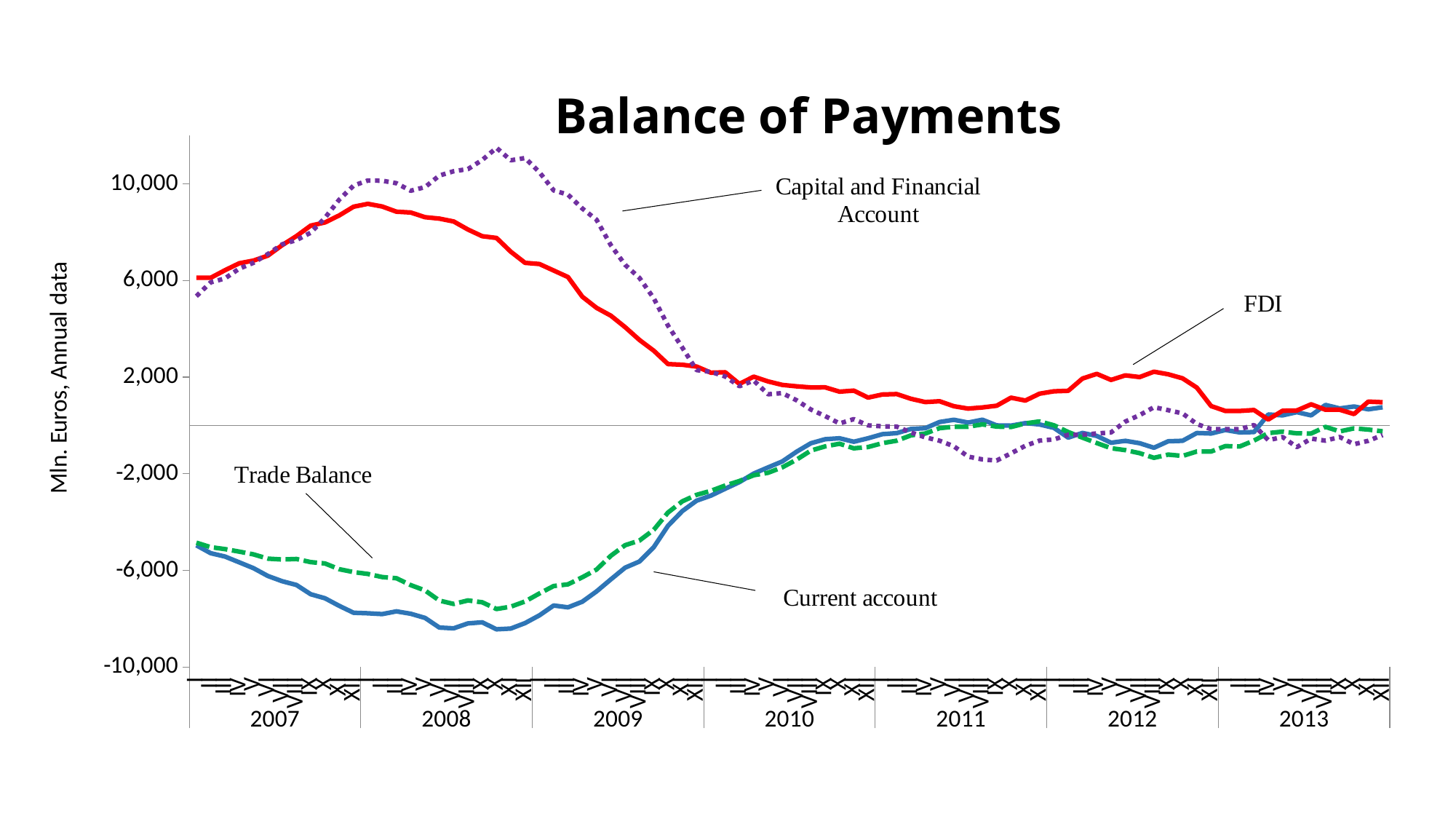
Which series reaches the lowest value on the chart? Current account Is the peak value of the Capital and Financial Account in 2008 greater or less than 10,000? greater Which series reaches the highest value on the chart? Capital and Financial Account Does the Current account rise or fall between 2008 and 2010? rise What is the title of the chart? Balance of Payments Is the value of the Current account at the start of 2007 greater or less than -2,000? less How many years are labelled along the x axis? 7 What is the label on the vertical axis of the chart? Mln. Euros, Annual data How many data series are plotted on the chart? 4 In 2007, which is higher, the Trade Balance or the Current account? Trade Balance What kind of chart is shown on the slide? line chart Does FDI rise or fall between 2008 and 2010? fall